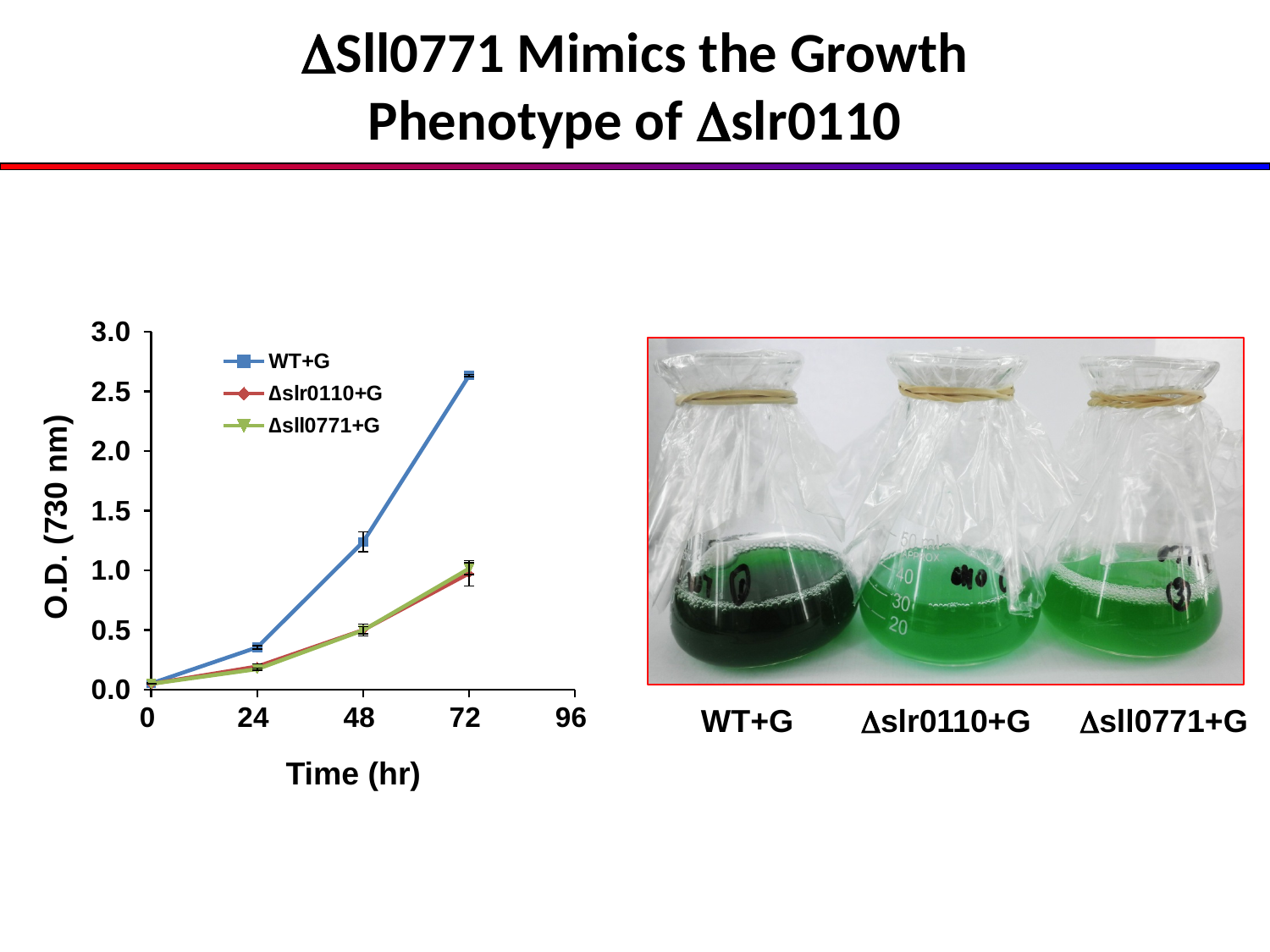
Does the O.D. of WT+G rise or fall as time increases from 0 to 72 hr? rise How many series does the legend of the chart list? 3 Which series has the highest O.D. at 72 hr? WT+G Is the O.D. value for WT+G at 72 hr greater or less than 2.0? greater Is the O.D. value for WT+G at 24 hr greater or less than 0.5? less At 48 hr, which series has the larger O.D., WT+G or Δslr0110+G? WT+G Is the O.D. value for Δslr0110+G at 24 hr greater or less than 0.5? less What is the label of the y axis of the chart? O.D. (730 nm) What kind of chart is shown on the slide? line chart How many time points are plotted for each series in the chart? 4